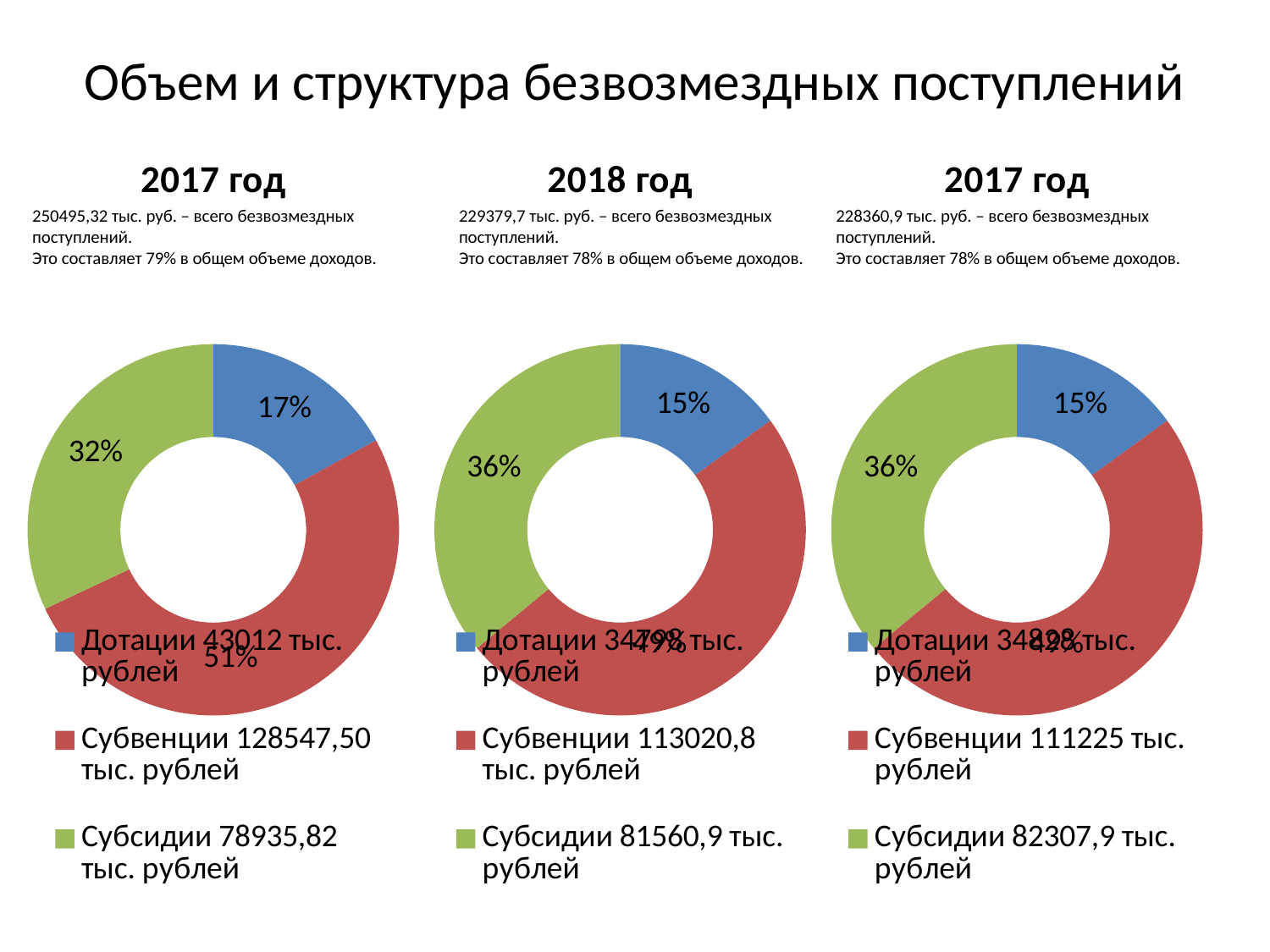
In the right chart, which category has the smallest slice? Дотации What type of chart is used on this slide? Doughnut (pie) chart In the middle chart (2018 год), what share of the doughnut is Дотации? 15% In the middle chart (2018 год), what value does the legend give for Субвенции? 113020,8 тыс. рублей In the middle chart (2018 год), what share of the doughnut is Субсидии? 36% In the left chart (2017 год), which category has the smallest slice? Дотации In the left chart (2017 год), what share of the doughnut is Дотации? 17% How many categories does the left chart (2017 год) show? 3 In the left chart (2017 год), which category has the largest slice? Субвенции In the left chart (2017 год), which slice is larger, Субсидии or Дотации? Субсидии